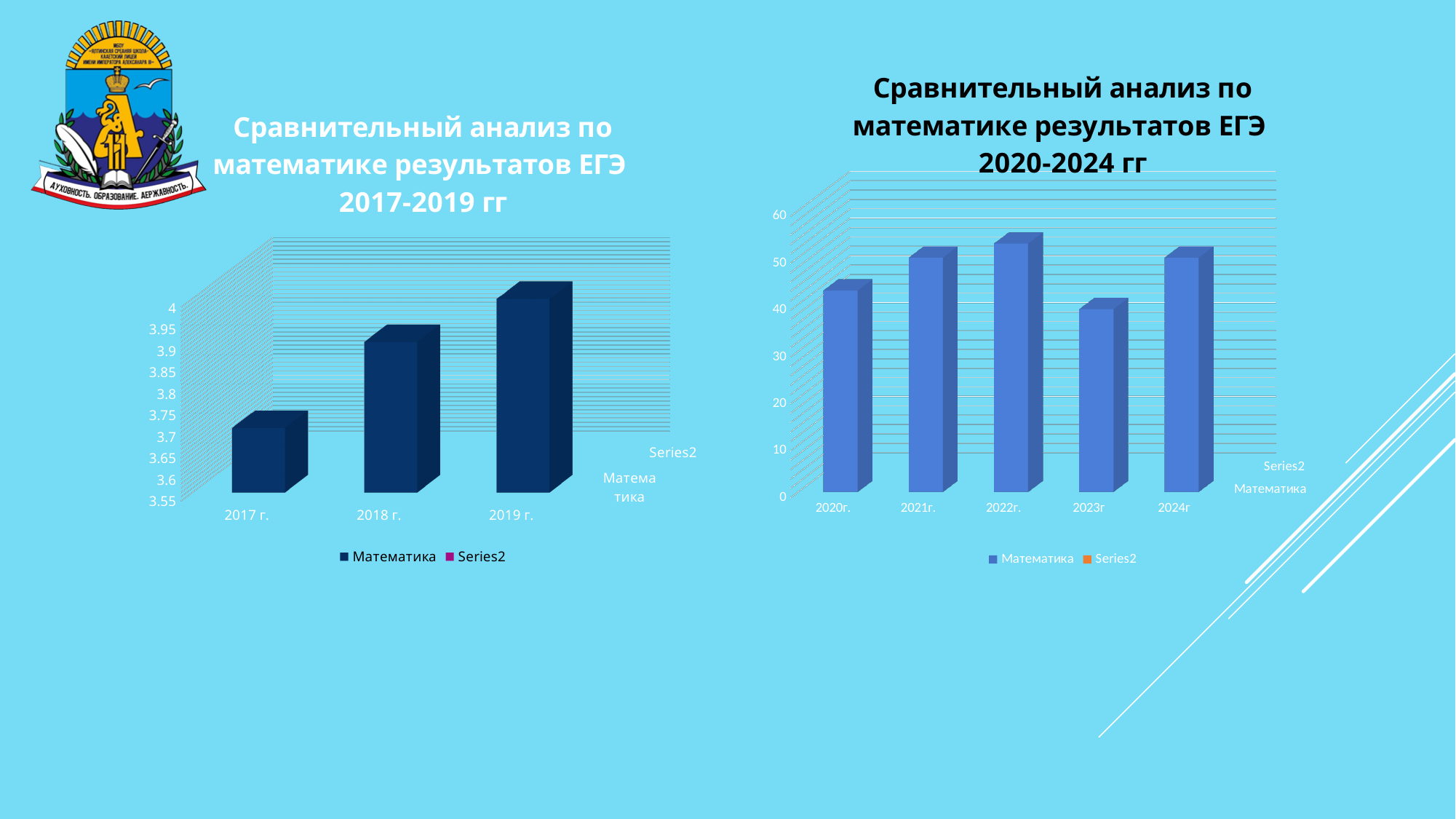
In the left chart (2017-2019), which year has the lowest value? 2017 г. In the left chart (2017-2019), is the value for 2019 г. greater or less than 3.9? greater In the right chart (2020-2024), which year has the lowest value? 2023г What kind of chart is the chart titled "Сравнительный анализ по математике результатов ЕГЭ 2017-2019 гг"? bar chart In the right chart (2020-2024), which year has the highest value? 2022г. In the left chart (2017-2019), is the value for 2017 г. greater or less than 3.8? less How many series does the legend of the right chart (2020-2024) list? 2 In the right chart (2020-2024), is the value for 2023г greater or less than 50? less In the left chart (2017-2019), which year has the highest value? 2019 г. In the left chart (2017-2019), how many years are shown on the x axis? 3 In the left chart (2017-2019), do the values rise or fall from 2017 to 2019? rise In the right chart (2020-2024), how many years are shown on the x axis? 5